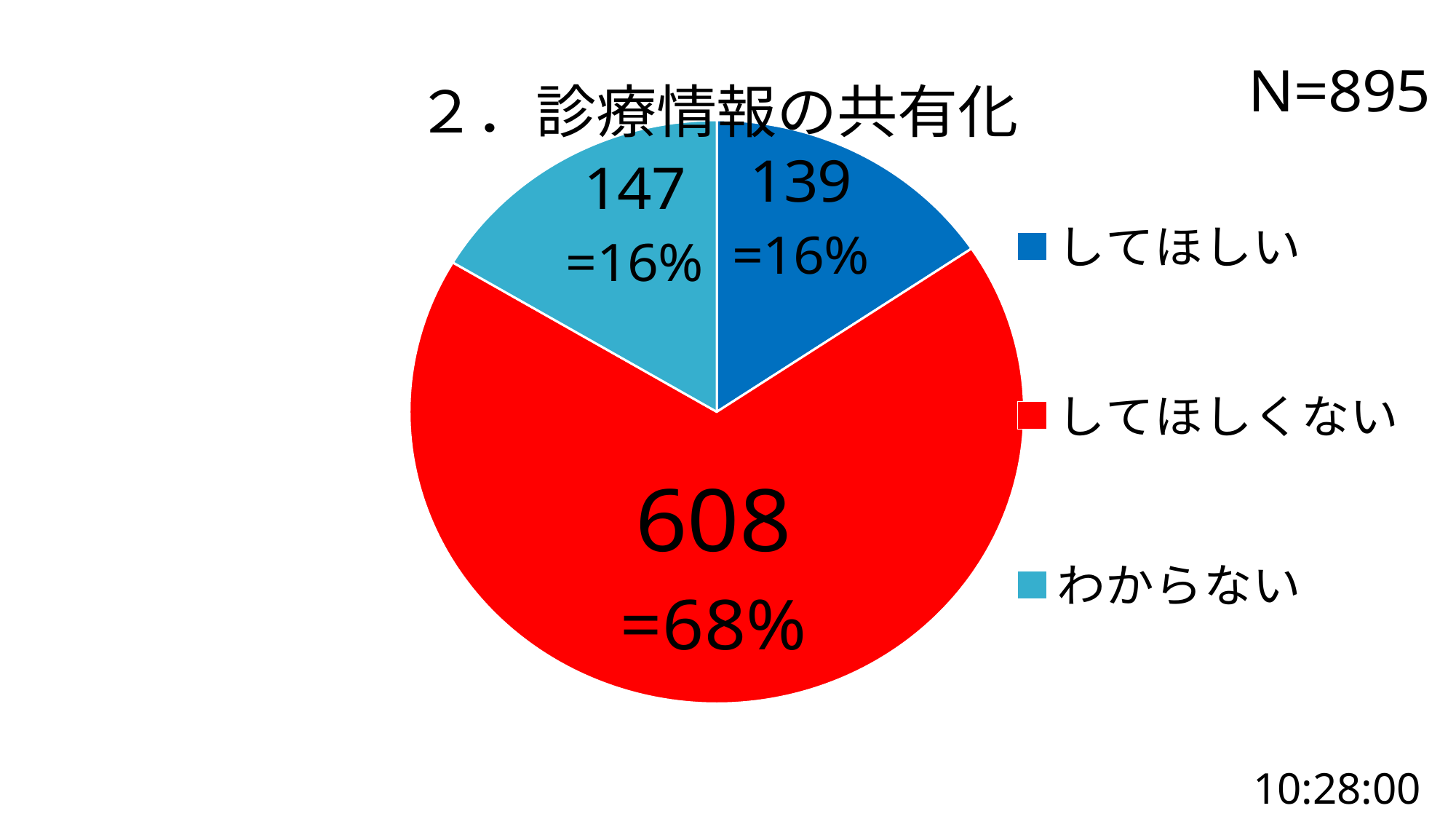
How many categories does the pie chart have? 3 What type of chart is shown on the slide? pie chart What is the title of the chart? ２．診療情報の共有化 Which category has the largest slice? してほしくない What is the difference between the values for わからない and してほしい? 8 What is the value for してほしい? 139 What is the difference between the values for してほしくない and わからない? 461 What is the value for わからない? 147 What percentage share of the pie does わからない have? 16% What percentage share of the pie does してほしくない have? 68% Which category has the smallest slice? してほしい What is the value for してほしくない? 608